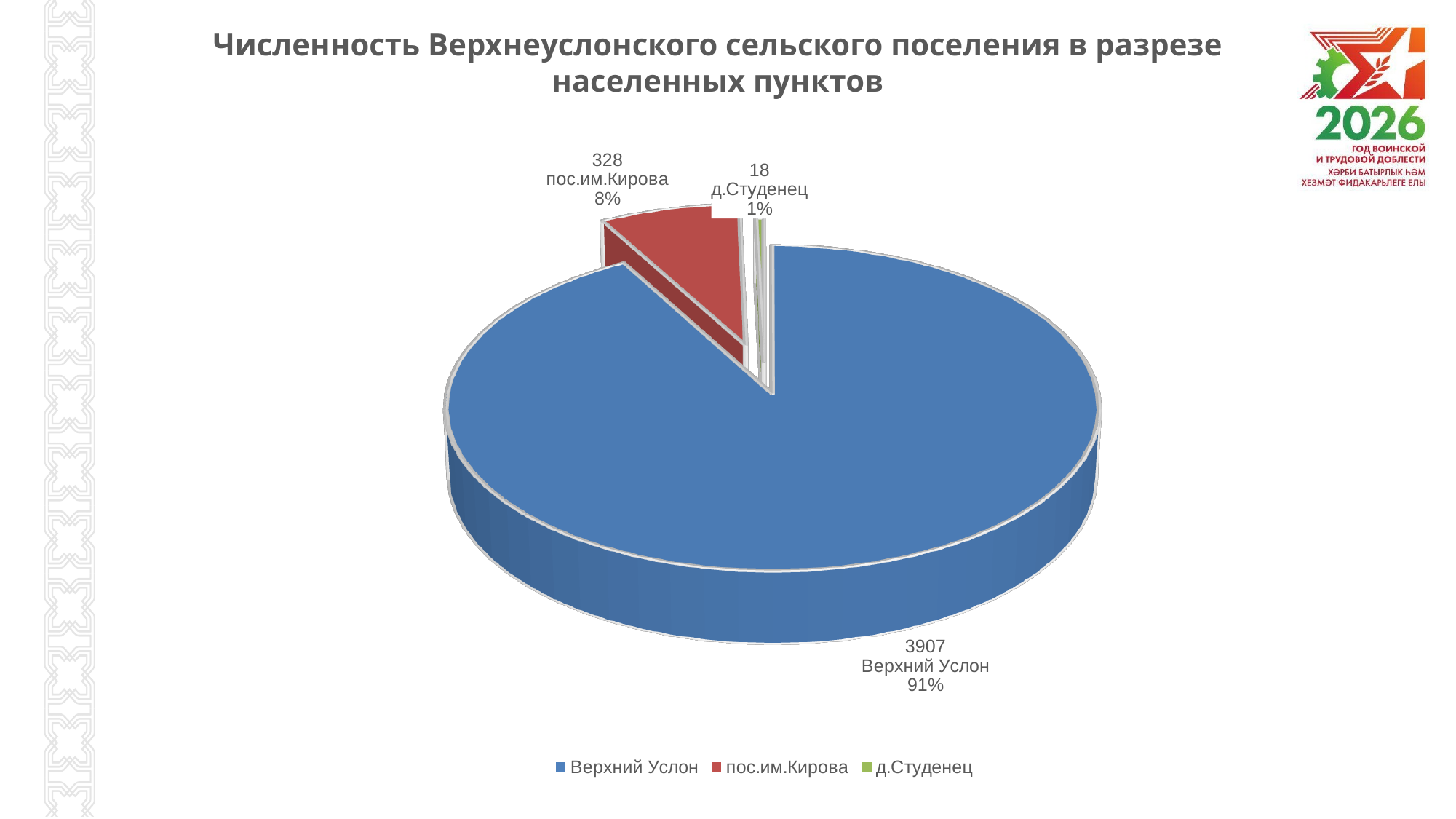
Which settlement has the largest share of the pie? Верхний Услон How many settlements are shown in the chart? 3 What is the population value shown for д.Студенец? 18 Which is larger, the value for пос.им.Кирова or the value for д.Студенец? пос.им.Кирова What percentage share of the pie does пос.им.Кирова have? 8% Which settlement has the smallest share of the pie? д.Студенец What type of chart is shown on the slide? Pie chart What is the population value shown for пос.им.Кирова? 328 What percentage share of the pie does Верхний Услон have? 91% What colour is the slice for пос.им.Кирова? Red What is the difference between the values for Верхний Услон and пос.им.Кирова? 3579 What is the population value shown for Верхний Услон? 3907